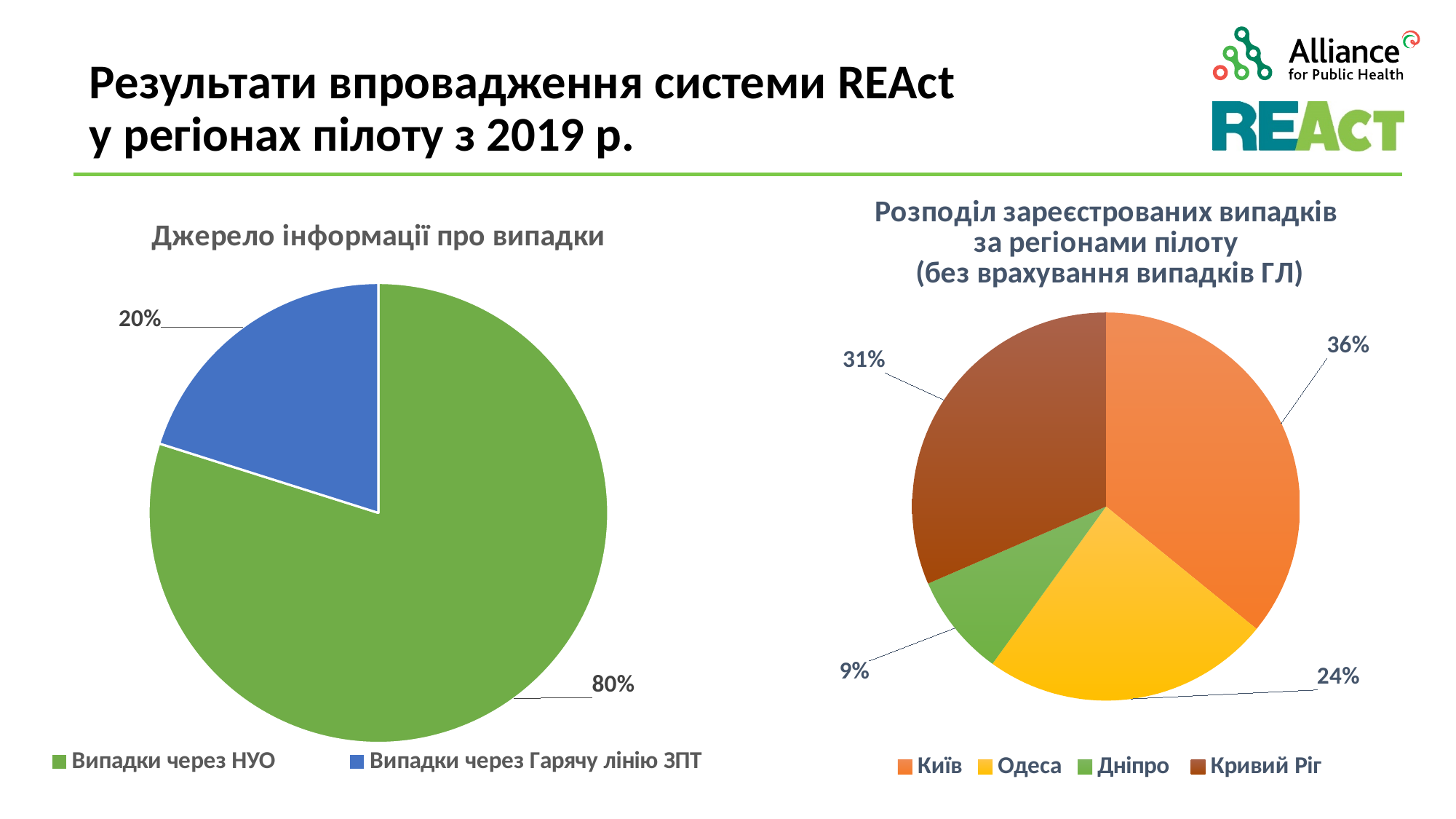
In the chart 'Джерело інформації про випадки', what share of cases came through 'Випадки через Гарячу лінію ЗПТ'? 20% In the chart 'Розподіл зареєстрованих випадків за регіонами пілоту', which has a larger share, Одеса or Кривий Ріг? Кривий Ріг In the chart 'Розподіл зареєстрованих випадків за регіонами пілоту', what share of cases is for Київ? 36% In the chart 'Розподіл зареєстрованих випадків за регіонами пілоту', what share of cases is for Дніпро? 9% What kind of chart is 'Джерело інформації про випадки'? Pie chart How many categories does the legend of the chart 'Джерело інформації про випадки' list? 2 In the chart 'Розподіл зареєстрованих випадків за регіонами пілоту', which region has the smallest share? Дніпро How many regions are shown in the chart 'Розподіл зареєстрованих випадків за регіонами пілоту'? 4 In the chart 'Розподіл зареєстрованих випадків за регіонами пілоту', which region has the largest share? Київ In the chart 'Розподіл зареєстрованих випадків за регіонами пілоту', what is the difference in percentage points between Київ and Кривий Ріг? 5